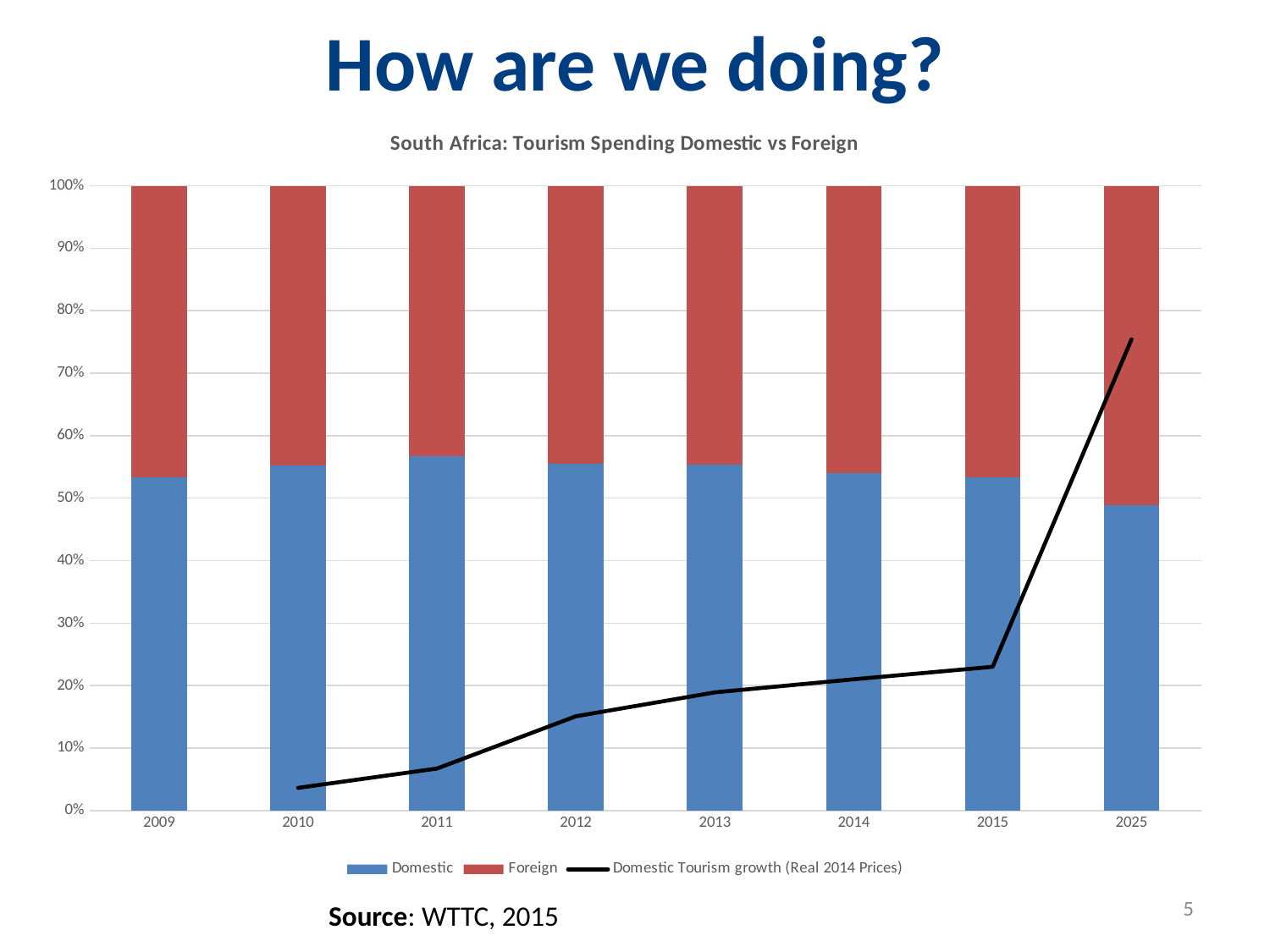
In which year does the Domestic Tourism growth (Real 2014 Prices) line reach its highest value? 2025 How many years are shown on the x axis of the chart? 8 What kind of chart is shown on the slide? Stacked bar chart with a line Is the Domestic Tourism growth (Real 2014 Prices) value for 2025 greater or less than 70%? greater Is the Domestic share for 2011 greater or less than 50%? greater What is the title of the chart? South Africa: Tourism Spending Domestic vs Foreign Is the Domestic Tourism growth (Real 2014 Prices) value for 2010 greater or less than 10%? less In which year is the Domestic share lowest? 2025 Does the Domestic Tourism growth (Real 2014 Prices) line rise or fall from 2010 to 2025? rise In 2011, which is larger, the Domestic share or the Foreign share? Domestic How many series does the legend list? 3